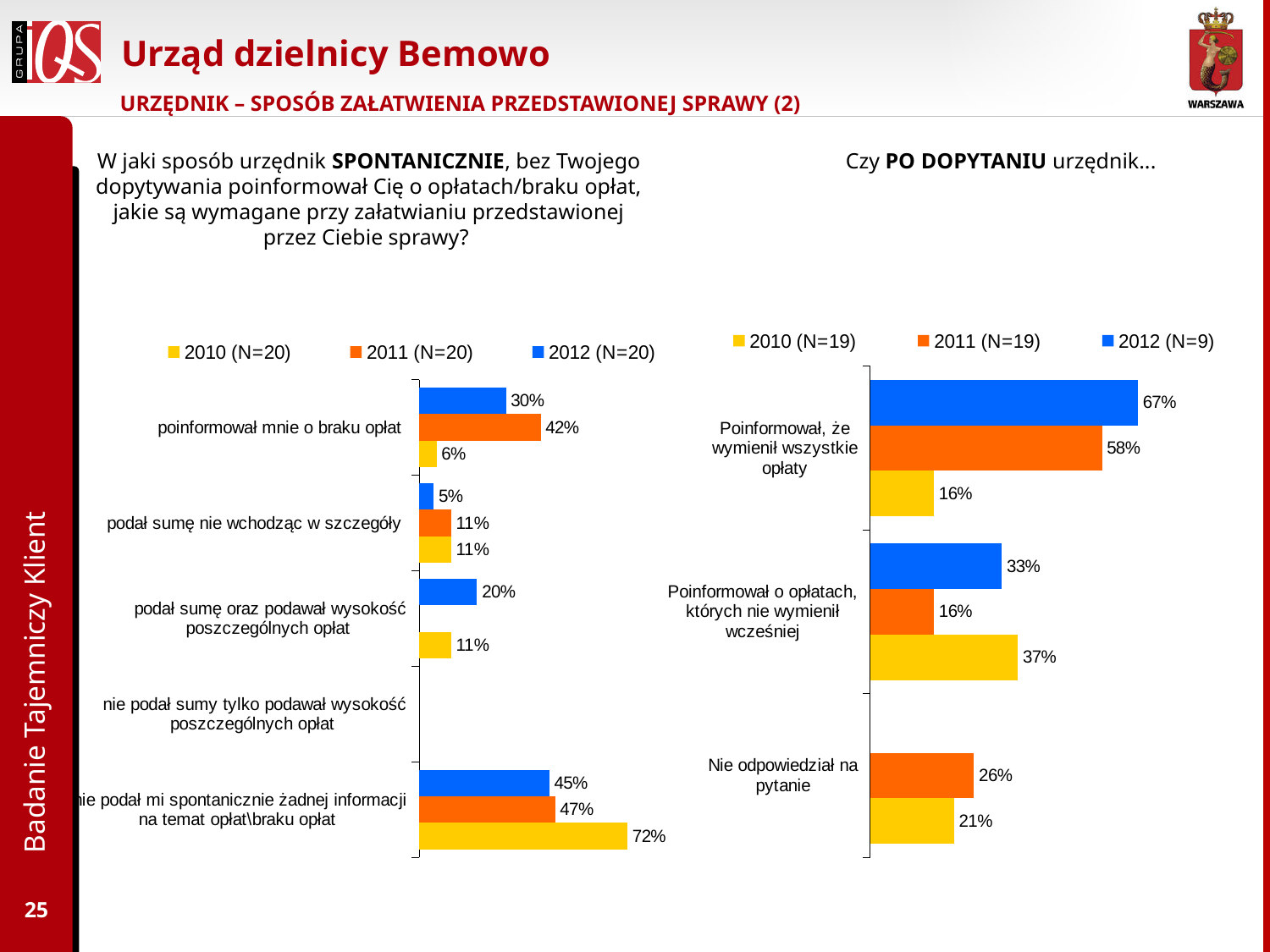
In the right chart (PO DOPYTANIU), what is the difference between the 2012 and 2011 values for 'Poinformował, że wymienił wszystkie opłaty'? 9% How many series does the legend of the right chart (PO DOPYTANIU) list? 3 In the right chart (PO DOPYTANIU), which year has the lowest value for 'Poinformował, że wymienił wszystkie opłaty'? 2010 In the left chart (SPONTANICZNIE), which is larger for 'poinformował mnie o braku opłat': the 2011 value or the 2012 value? 2011 In the left chart (SPONTANICZNIE), what is the 2011 value for 'poinformował mnie o braku opłat'? 42% In the right chart (PO DOPYTANIU), what sample size (N) does the legend give for 2012? N=9 In the right chart (PO DOPYTANIU), what is the 2010 value for 'Poinformował o opłatach, których nie wymienił wcześniej'? 37% In the left chart (SPONTANICZNIE), what is the 2010 value for 'nie podał mi spontanicznie żadnej informacji na temat opłat\braku opłat'? 72% In the right chart (PO DOPYTANIU), what is the 2012 value for 'Poinformował, że wymienił wszystkie opłaty'? 67% What type of chart is the left chart (SPONTANICZNIE)? bar chart In the left chart (SPONTANICZNIE), which category has the highest 2012 value? nie podał mi spontanicznie żadnej informacji na temat opłat\braku opłat In the left chart (SPONTANICZNIE), what is the difference between the 2010 and 2012 values for 'nie podał mi spontanicznie żadnej informacji na temat opłat\braku opłat'? 27%